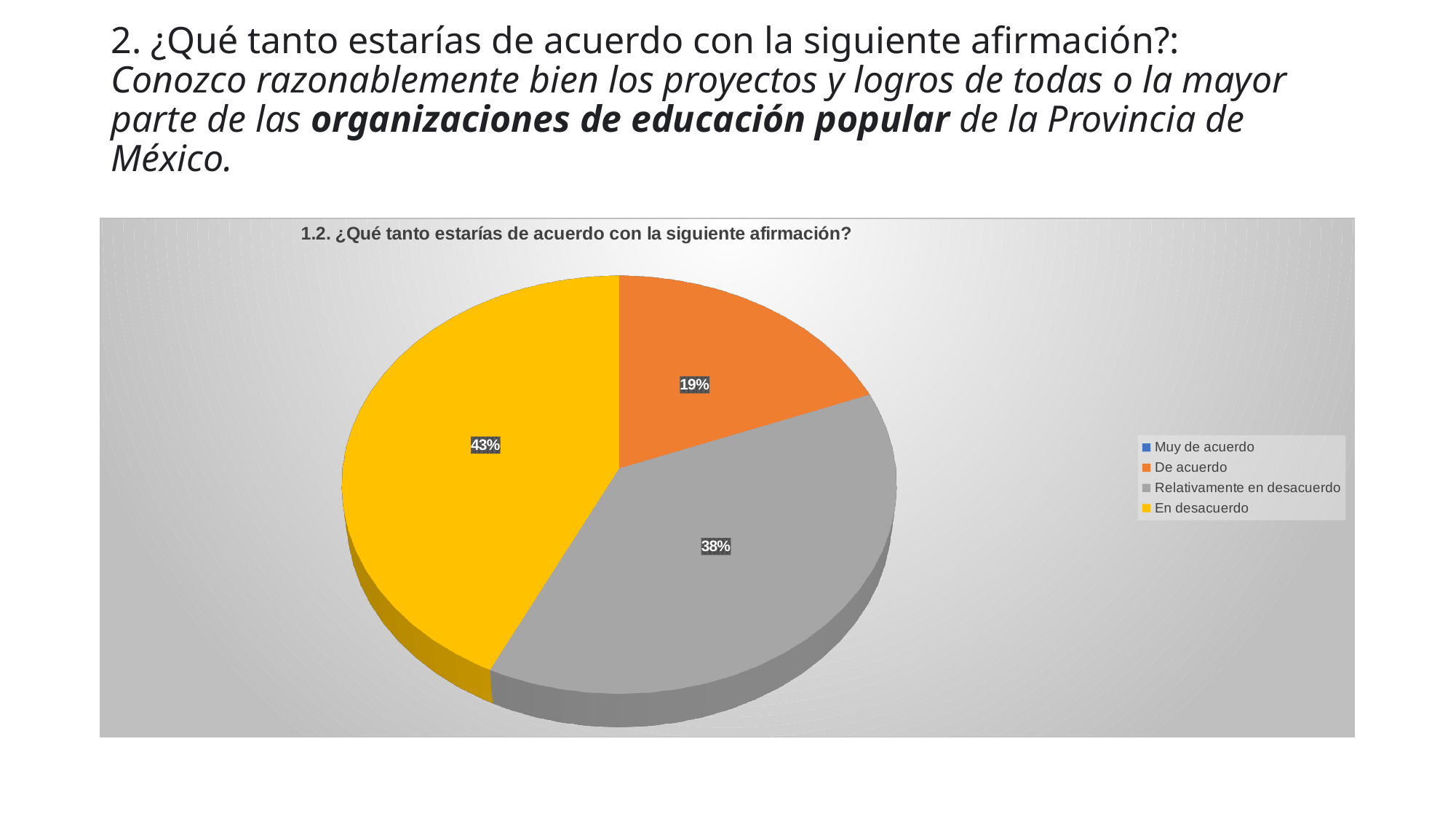
What is the difference in percentage points between "En desacuerdo" and "Relativamente en desacuerdo"? 5 Which response category has the largest share of the pie? En desacuerdo What percentage of respondents answered "De acuerdo"? 19% What percentage of respondents answered "En desacuerdo"? 43% What colour is the slice for "En desacuerdo"? yellow What is the title of the chart? 1.2. ¿Qué tanto estarías de acuerdo con la siguiente afirmación? How many entries does the legend list? 4 Among the slices with a printed label, which response category has the smallest share? De acuerdo What is the difference in percentage points between "En desacuerdo" and "De acuerdo"? 24 What kind of chart is shown on the slide? pie chart Which is larger: the share for "Relativamente en desacuerdo" or the share for "De acuerdo"? Relativamente en desacuerdo What percentage of respondents answered "Relativamente en desacuerdo"? 38%